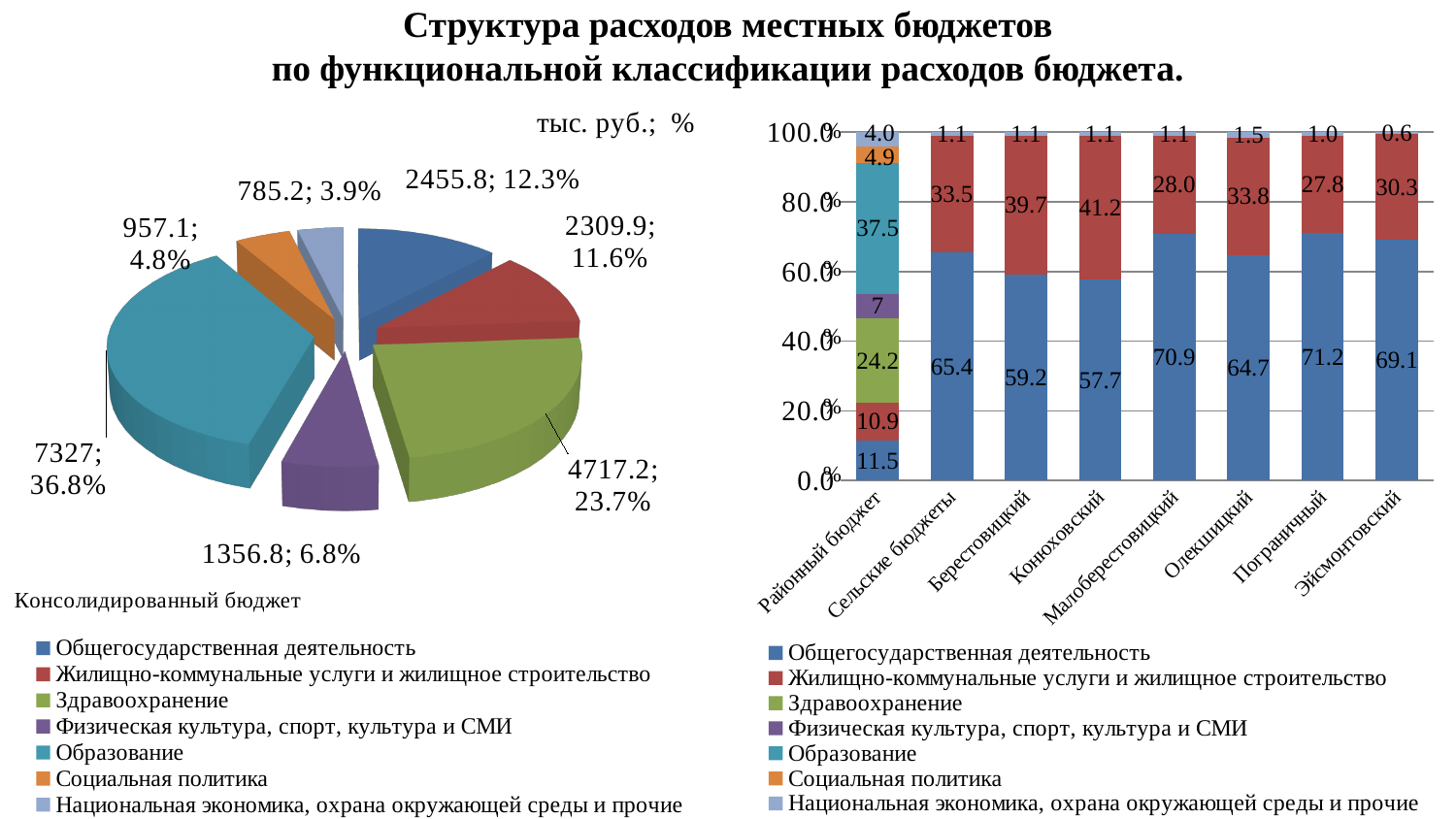
In the stacked bar chart on the right, what is the value of Образование for Районный бюджет? 37.5 In the stacked bar chart on the right, how many categories are shown on the x axis? 8 In the stacked bar chart on the right, which category has the highest value for Жилищно-коммунальные услуги и жилищное строительство? Конюховский In the pie chart on the left, what share does Здравоохранение have? 23.7% In the stacked bar chart on the right, what is the value of Общегосударственная деятельность for Пограничный? 71.2 In the pie chart on the left, which is larger: the value for Общегосударственная деятельность or for Жилищно-коммунальные услуги и жилищное строительство? Общегосударственная деятельность In the pie chart on the left, which category has the smallest share? Национальная экономика, охрана окружающей среды и прочие In the stacked bar chart on the right, what is the difference between the Общегосударственная деятельность values for Пограничный and Конюховский? 13.5 In the pie chart on the left, which category has the largest share? Образование In the pie chart on the left, what value and share are shown for the Образование slice? 7327; 36.8% How many series does the legend of the stacked bar chart on the right list? 7 In the pie chart on the left, how many slices are there? 7